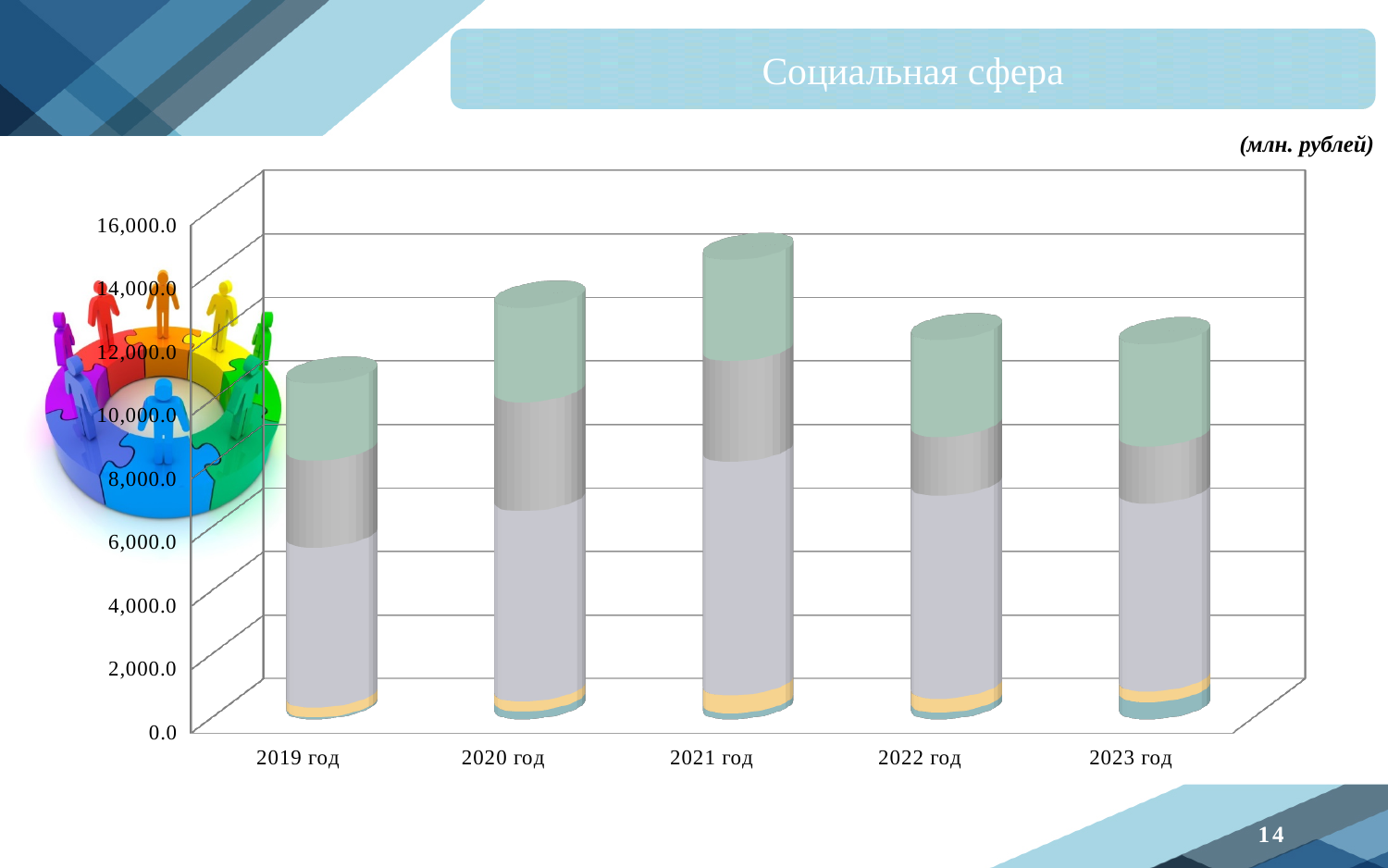
What is the title of the chart slide? Социальная сфера Is the total value for 2022 год greater or less than 14,000.0? less What kind of chart is shown on the slide? Stacked bar chart Which year has the tallest bar in the chart? 2021 год Which bar is taller, 2020 год or 2022 год? 2020 год Which year has the shortest bar in the chart? 2019 год In what units are the chart values given, according to the slide? млн. рублей Is the total value for 2019 год greater or less than 10,000.0? greater Do the bar totals rise or fall from 2019 год to 2021 год? rise Is the total value for 2020 год greater or less than 12,000.0? greater How many years are shown on the x axis of the chart? 5